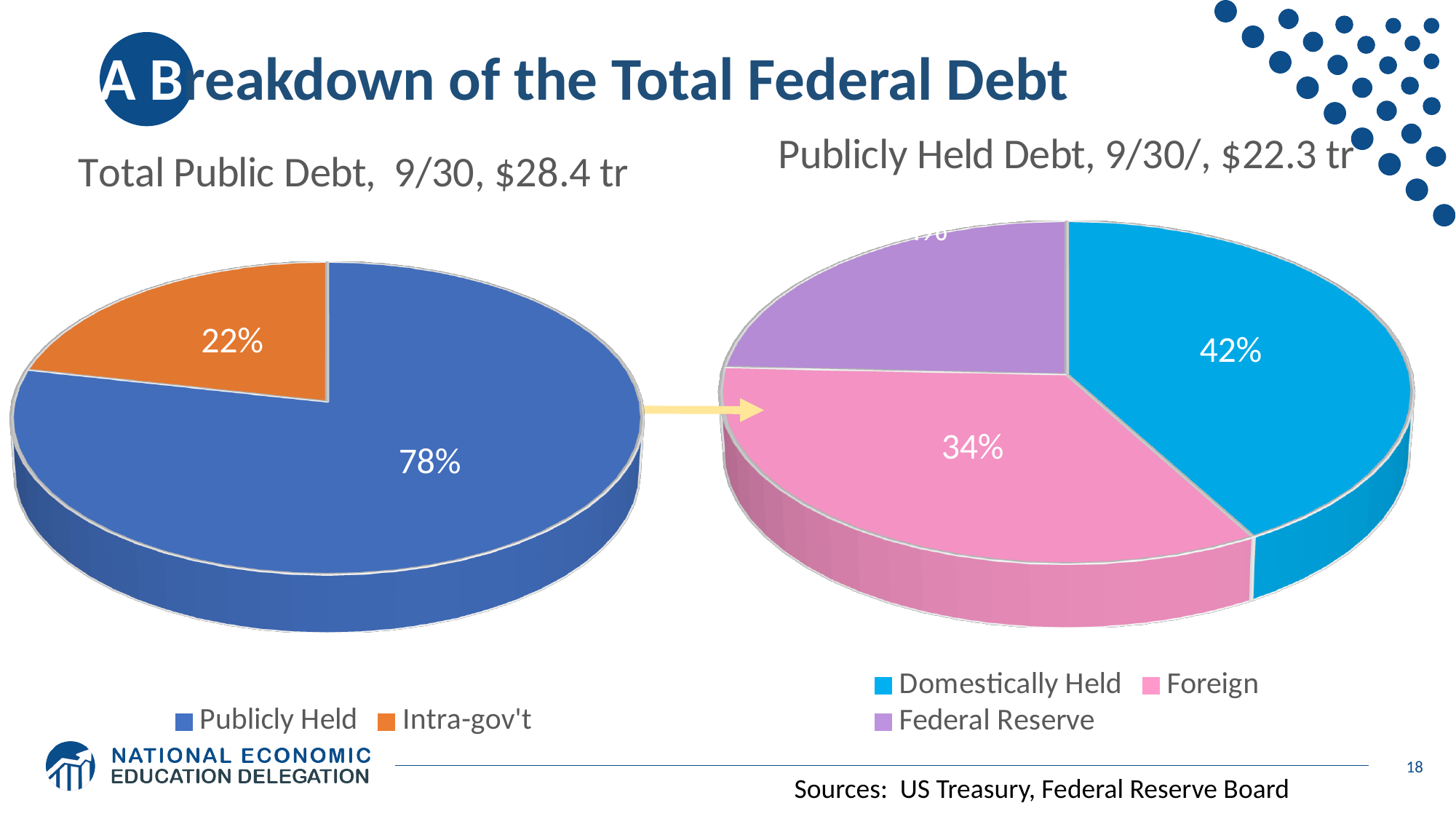
In the Total Public Debt pie chart, what share is Intra-gov't? 22% In the Publicly Held Debt pie chart, what share is Domestically Held? 42% In the Publicly Held Debt pie chart, what is the difference in percentage points between Domestically Held and Foreign? 8 In the Total Public Debt pie chart, what share is Publicly Held? 78% In the Publicly Held Debt pie chart, which category has the largest share? Domestically Held In the Total Public Debt pie chart, which category has the largest share? Publicly Held In the Publicly Held Debt pie chart, which is larger, Domestically Held or Foreign? Domestically Held In the Publicly Held Debt pie chart, which category has the smallest share? Federal Reserve In the Total Public Debt pie chart, what is the difference in percentage points between Publicly Held and Intra-gov't? 56 In the Publicly Held Debt pie chart, what share is Foreign? 34% What kind of chart is the Total Public Debt chart on the left? Pie chart How many categories does the legend of the Publicly Held Debt pie chart list? 3